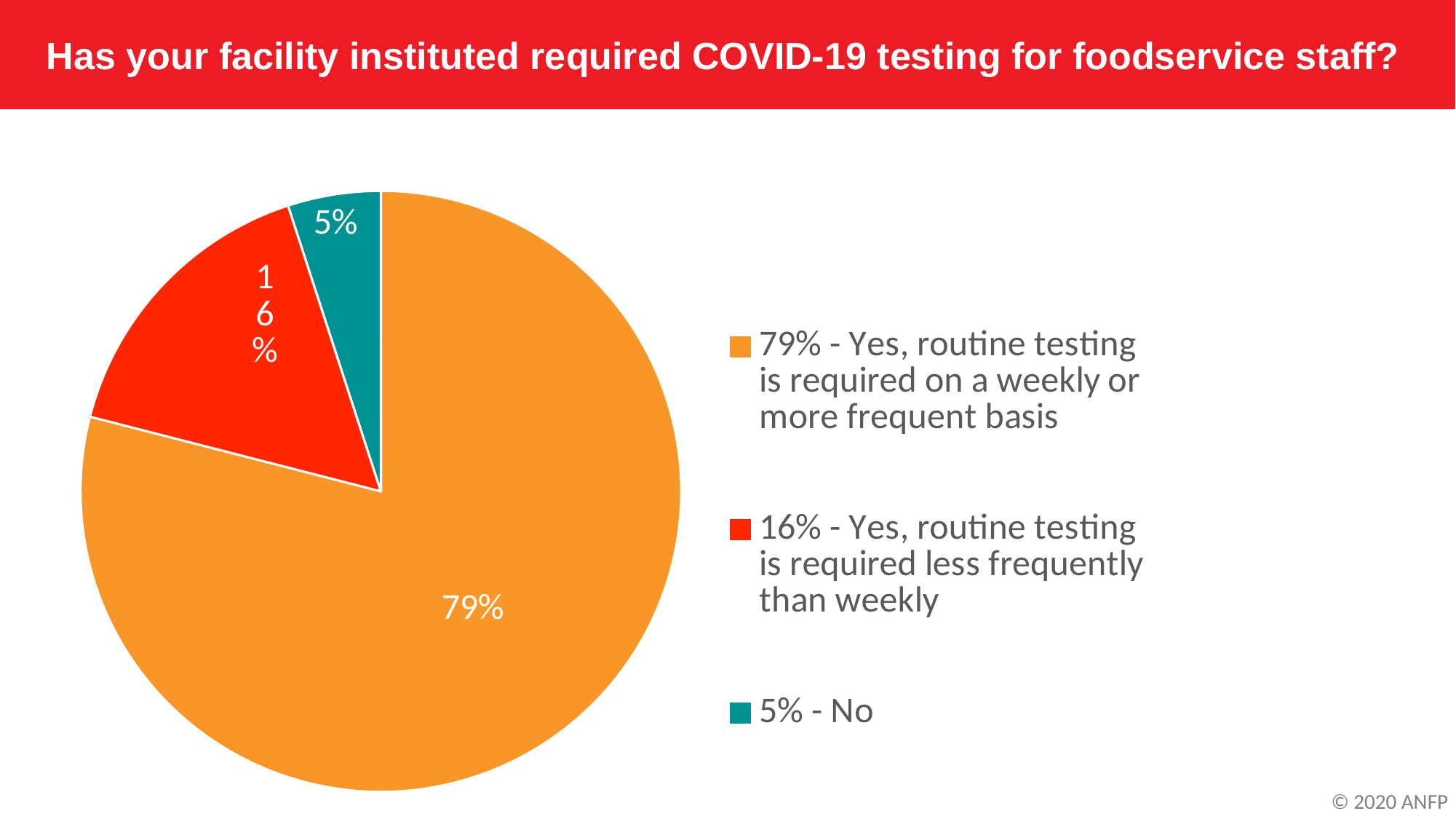
What is the title of the slide? Has your facility instituted required COVID-19 testing for foodservice staff? What is the difference in percentage points between the weekly-or-more-frequent testing slice and the less-frequently-than-weekly slice? 63 What percentage of facilities require routine testing less frequently than weekly? 16% How many entries does the legend list? 3 Which response has the largest share of the pie? Yes, routine testing is required on a weekly or more frequent basis What kind of chart is shown on the slide? pie chart How many slices does the pie chart have? 3 What percentage of facilities require routine testing on a weekly or more frequent basis? 79% What share of respondents answered 'No'? 5% What colour is the slice representing 'No'? teal Which is larger: the share for testing less frequently than weekly or the share for 'No'? testing less frequently than weekly Which response has the smallest share of the pie? No